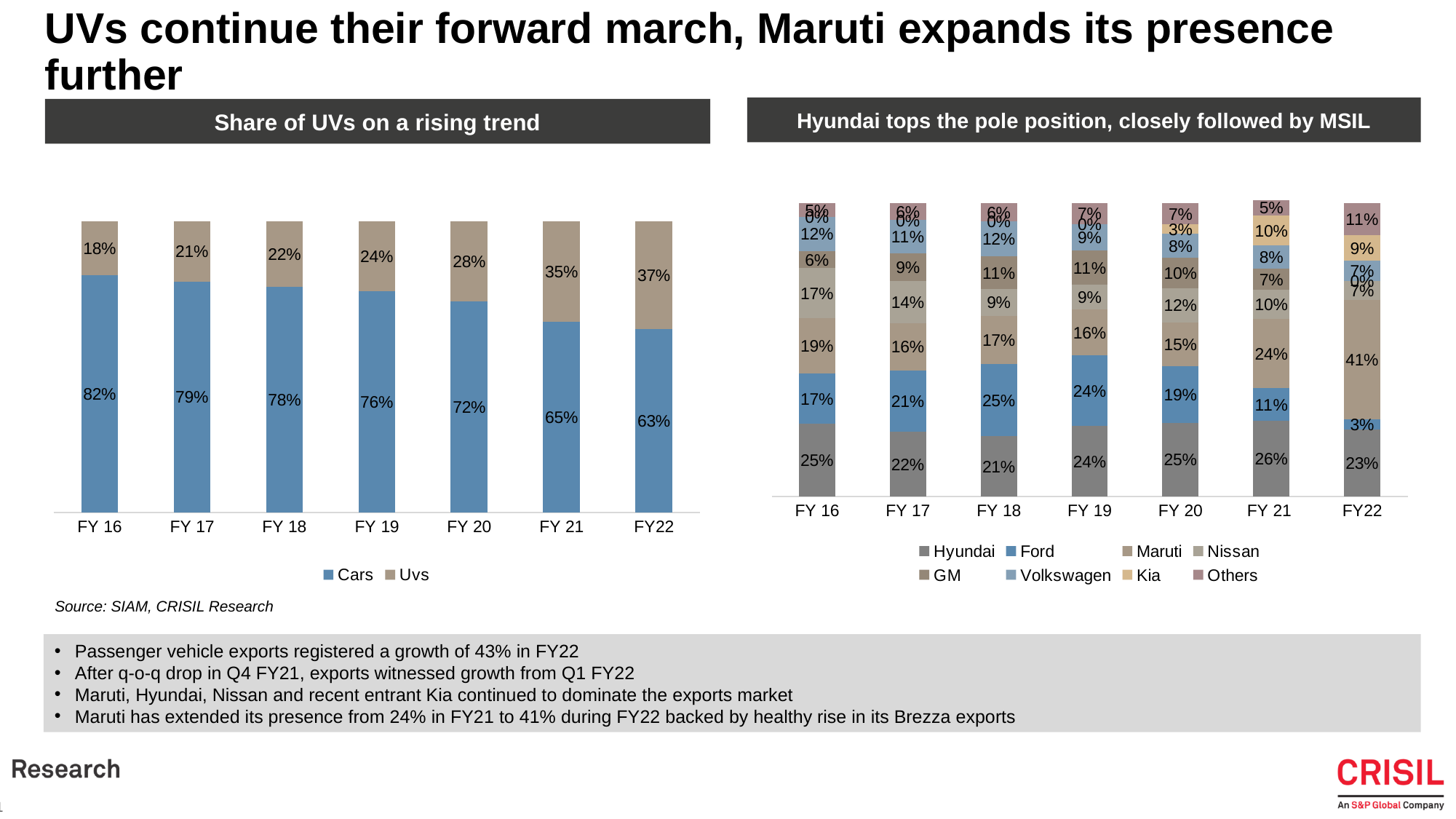
In the 'Share of UVs on a rising trend' chart, how many series does the legend list? 2 In the 'Hyundai tops the pole position, closely followed by MSIL' chart, what is Ford's share in FY22? 3% In the 'Hyundai tops the pole position, closely followed by MSIL' chart, which is larger in FY 18: Ford's share or Hyundai's share? Ford In the 'Share of UVs on a rising trend' chart, does the share of UVs rise or fall from FY 16 to FY22? rise In the 'Share of UVs on a rising trend' chart, in which fiscal year is the share of Cars lowest? FY22 In the 'Share of UVs on a rising trend' chart, what is the difference between the UV share in FY 21 and FY 20? 7% What type of chart is the 'Hyundai tops the pole position, closely followed by MSIL' chart? Stacked bar chart In the 'Share of UVs on a rising trend' chart, what is the share of UVs in FY22? 37% In the 'Share of UVs on a rising trend' chart, what is the share of Cars in FY 16? 82% In the 'Hyundai tops the pole position, closely followed by MSIL' chart, what is Hyundai's share in FY 21? 26% In the 'Hyundai tops the pole position, closely followed by MSIL' chart, how many series does the legend list? 8 In the 'Hyundai tops the pole position, closely followed by MSIL' chart, what is Maruti's share in FY22? 41%